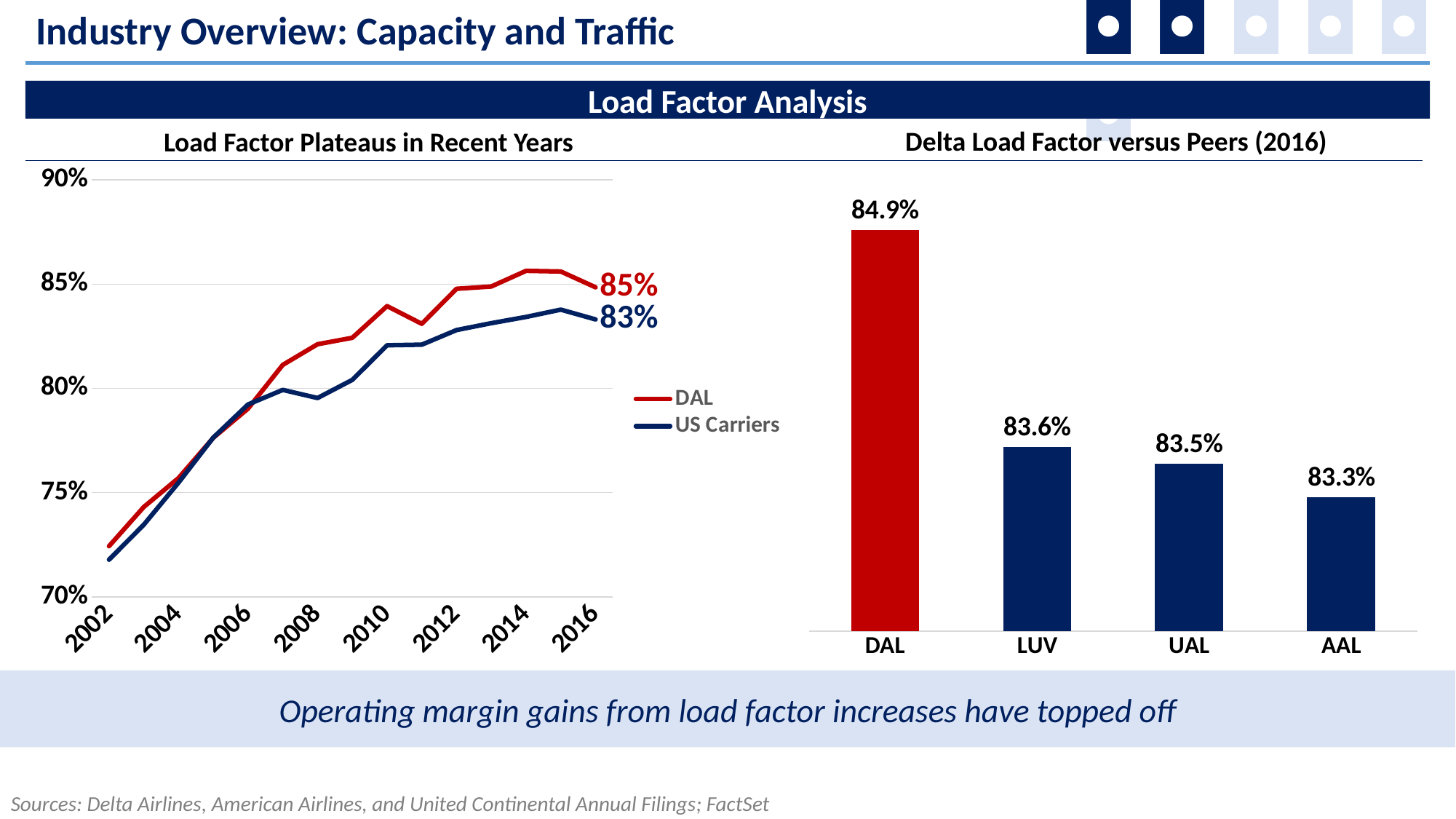
In the 'Delta Load Factor versus Peers (2016)' chart, what is the difference between the DAL and AAL load factors? 1.6% What kind of chart is 'Delta Load Factor versus Peers (2016)'? Bar chart In the 'Load Factor Plateaus in Recent Years' chart, what is the US Carriers load factor in 2016? 83% In the 'Load Factor Plateaus in Recent Years' chart, what is the DAL load factor in 2016? 85% In the 'Load Factor Plateaus in Recent Years' chart, how many series does the legend list? 2 In the 'Load Factor Plateaus in Recent Years' chart, is the DAL value for 2002 greater or less than 75%? less In the 'Delta Load Factor versus Peers (2016)' chart, how many airlines are shown? 4 In the 'Delta Load Factor versus Peers (2016)' chart, what is the load factor for AAL? 83.3% In the 'Load Factor Plateaus in Recent Years' chart, do the load factors generally rise or fall from 2002 to 2016? rise In the 'Delta Load Factor versus Peers (2016)' chart, which airline has the highest load factor? DAL In the 'Delta Load Factor versus Peers (2016)' chart, what is the load factor for DAL? 84.9% In the 'Delta Load Factor versus Peers (2016)' chart, which airline has the lowest load factor? AAL